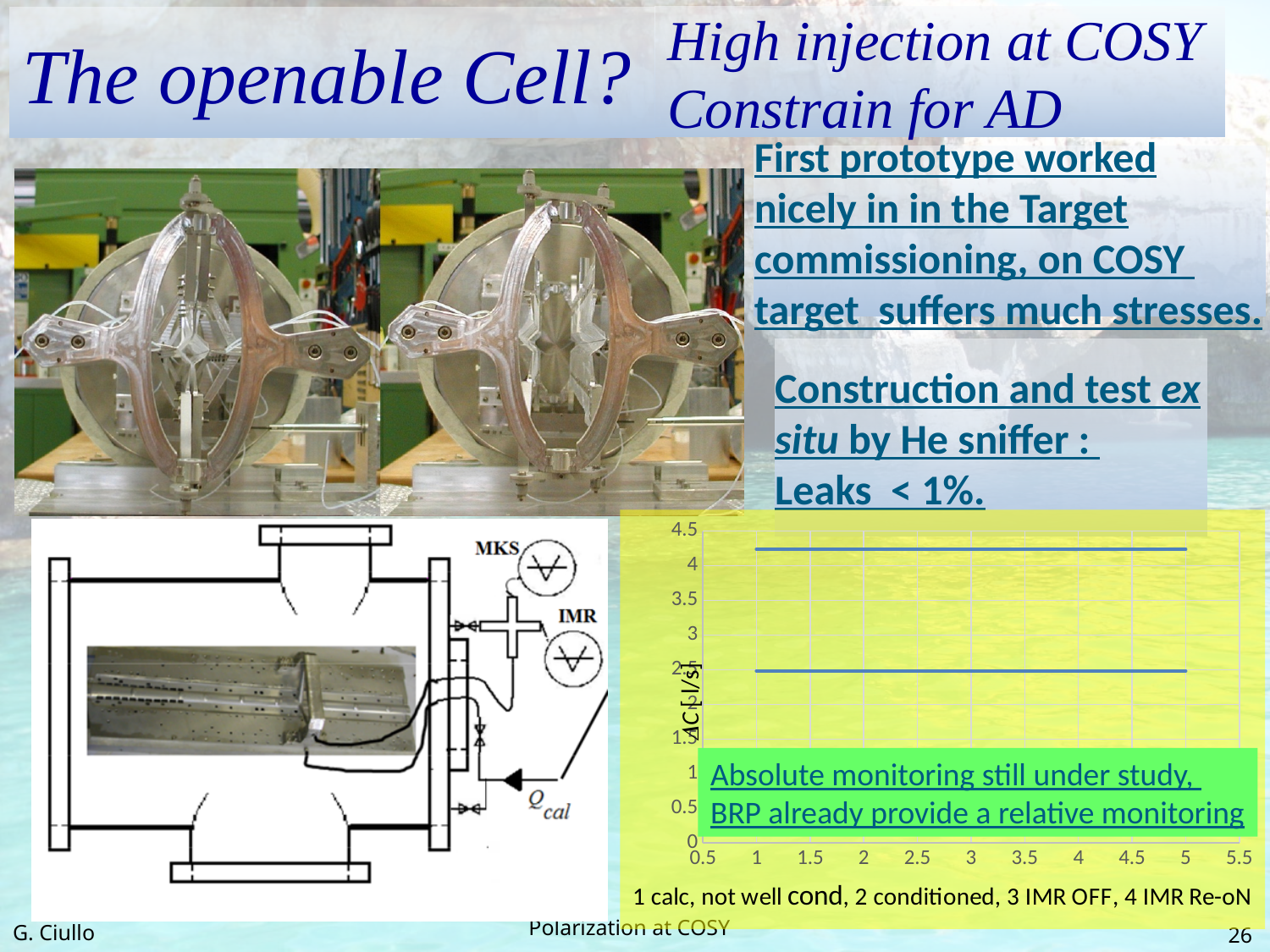
What is the label on the y axis of the chart? ΔC [l/s] Which of the two horizontal lines in the chart has the larger ΔC value, the upper or the lower one? the upper one What is the highest tick value shown on the y axis of the chart? 4.5 Is the value of the lower horizontal line in the chart greater or less than 3? less Is the value of the lower horizontal line in the chart greater or less than 2? greater How many horizontal data lines are visible in the chart? 2 What is the highest tick value shown on the x axis of the chart? 5.5 Does the chart's y axis start at 0? yes What kind of chart is shown in the lower right of the slide? line chart What is the spacing between consecutive tick marks on the x axis of the chart? 0.5 What is the lowest tick value shown on the x axis of the chart? 0.5 Is the value of the upper horizontal line in the chart greater or less than 4? greater